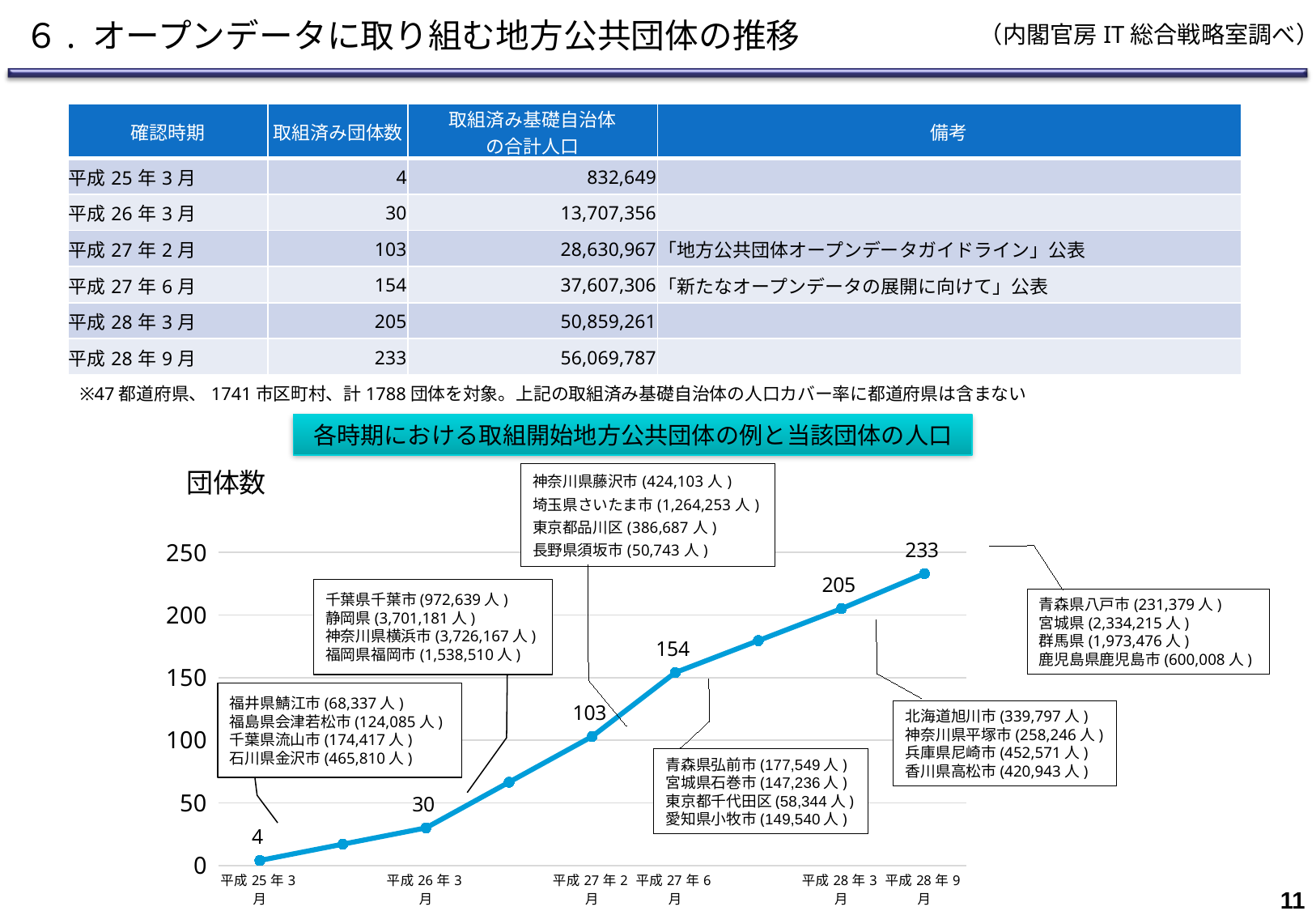
What label is shown above the y axis of the line chart? 団体数 What is the difference between the values for 平成28年9月 and 平成28年3月 in the line chart? 28 What is the value plotted for 平成25年3月 in the line chart? 4 Which x-axis period has the lowest value in the line chart? 平成25年3月 Which x-axis period has the highest value in the line chart? 平成28年9月 What is the value plotted for 平成27年6月 in the line chart? 154 What is the value plotted for 平成28年9月 in the line chart? 233 Do the values in the line chart rise or fall from left to right along the x axis? rise What kind of chart is shown on the slide? line chart What is the difference between the values for 平成27年6月 and 平成27年2月 in the line chart? 51 Is the value for 平成28年3月 in the line chart greater or less than 200? greater Which has the larger value in the line chart, 平成27年2月 or 平成26年3月? 平成27年2月